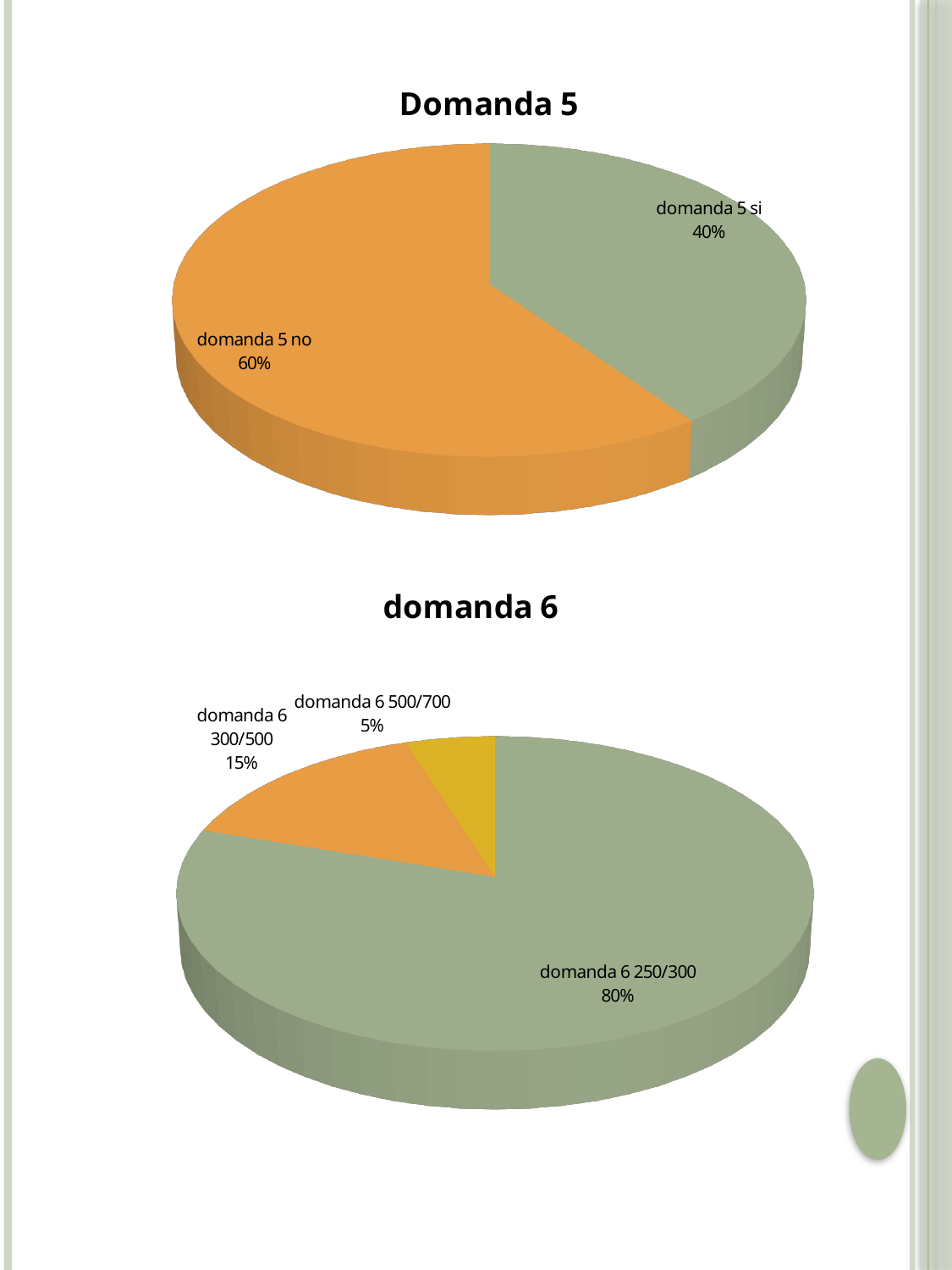
In the 'domanda 6' chart, which is larger: 'domanda 6 300/500' or 'domanda 6 500/700'? domanda 6 300/500 What kind of chart is the 'Domanda 5' chart? pie chart In the 'Domanda 5' chart, what colour is the 'domanda 5 no' slice? orange In the 'domanda 6' chart, which slice is the smallest? domanda 6 500/700 In the 'domanda 6' chart, what percentage is shown for 'domanda 6 300/500'? 15% In the 'Domanda 5' chart, which slice is the largest? domanda 5 no In the 'Domanda 5' chart, what is the difference in percentage points between 'domanda 5 no' and 'domanda 5 si'? 20 In the 'domanda 6' chart, what percentage is shown for 'domanda 6 250/300'? 80% In the 'Domanda 5' chart, what percentage is shown for 'domanda 5 no'? 60% In the 'Domanda 5' chart, what percentage is shown for 'domanda 5 si'? 40% In the 'domanda 6' chart, what is the difference in percentage points between 'domanda 6 250/300' and 'domanda 6 300/500'? 65 How many slices does the 'domanda 6' chart have? 3